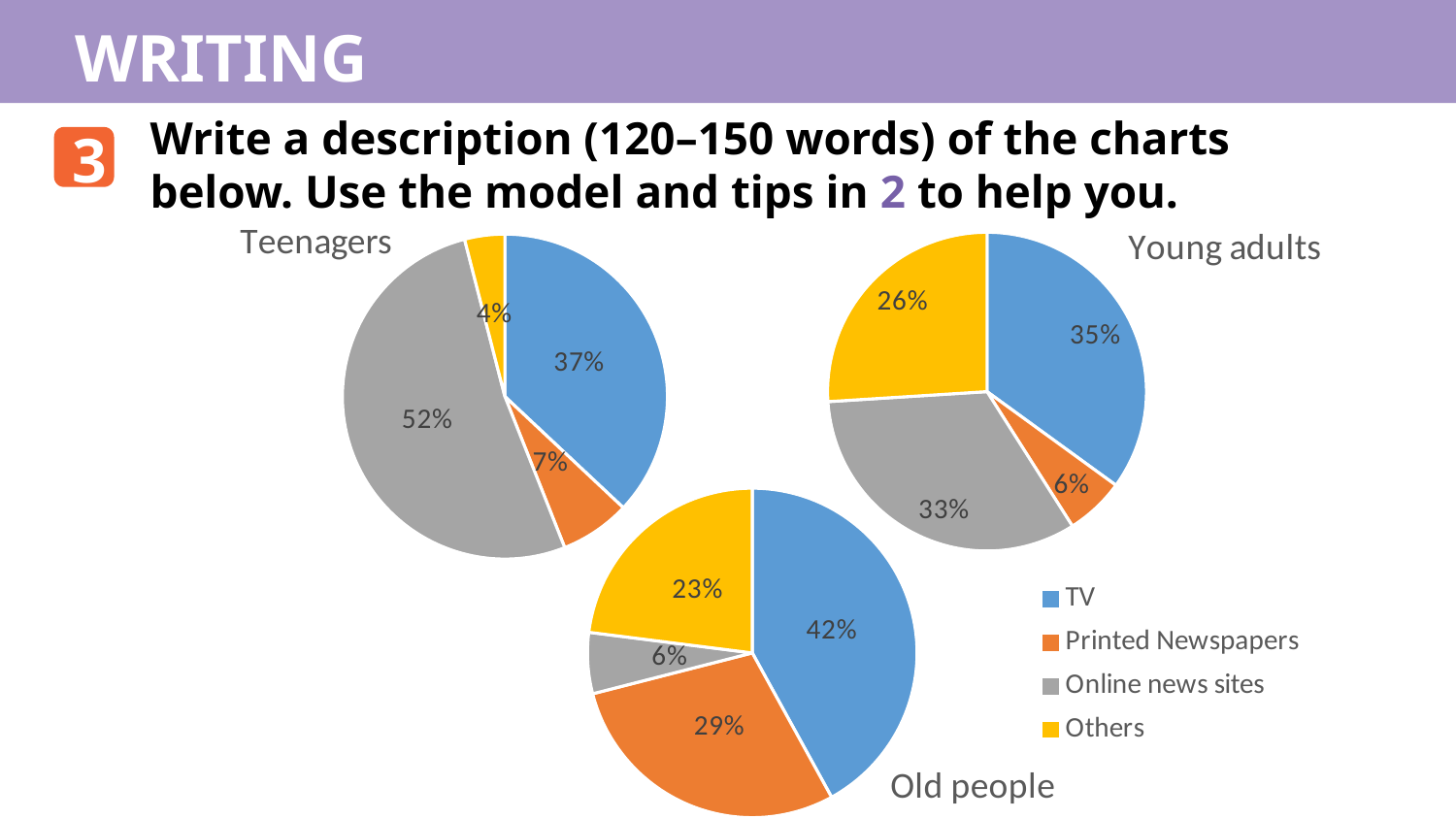
What kind of charts are shown on the slide? Pie charts Which colour represents Others in the legend? Yellow In the Old people pie chart, which category has the smallest share? Online news sites In the Young adults pie chart, what share is Others? 26% How many categories does the legend list? 4 In the Old people pie chart, what is the difference between the TV share and the Printed Newspapers share? 13% In the Teenagers pie chart, which is larger: the share for TV or the share for Online news sites? Online news sites In the Old people pie chart, what share is Printed Newspapers? 29% In the Teenagers pie chart, which category has the largest share? Online news sites In the Young adults pie chart, which category has the smallest share? Printed Newspapers In the Teenagers pie chart, what share is Online news sites? 52% How many pie charts are on the slide? 3